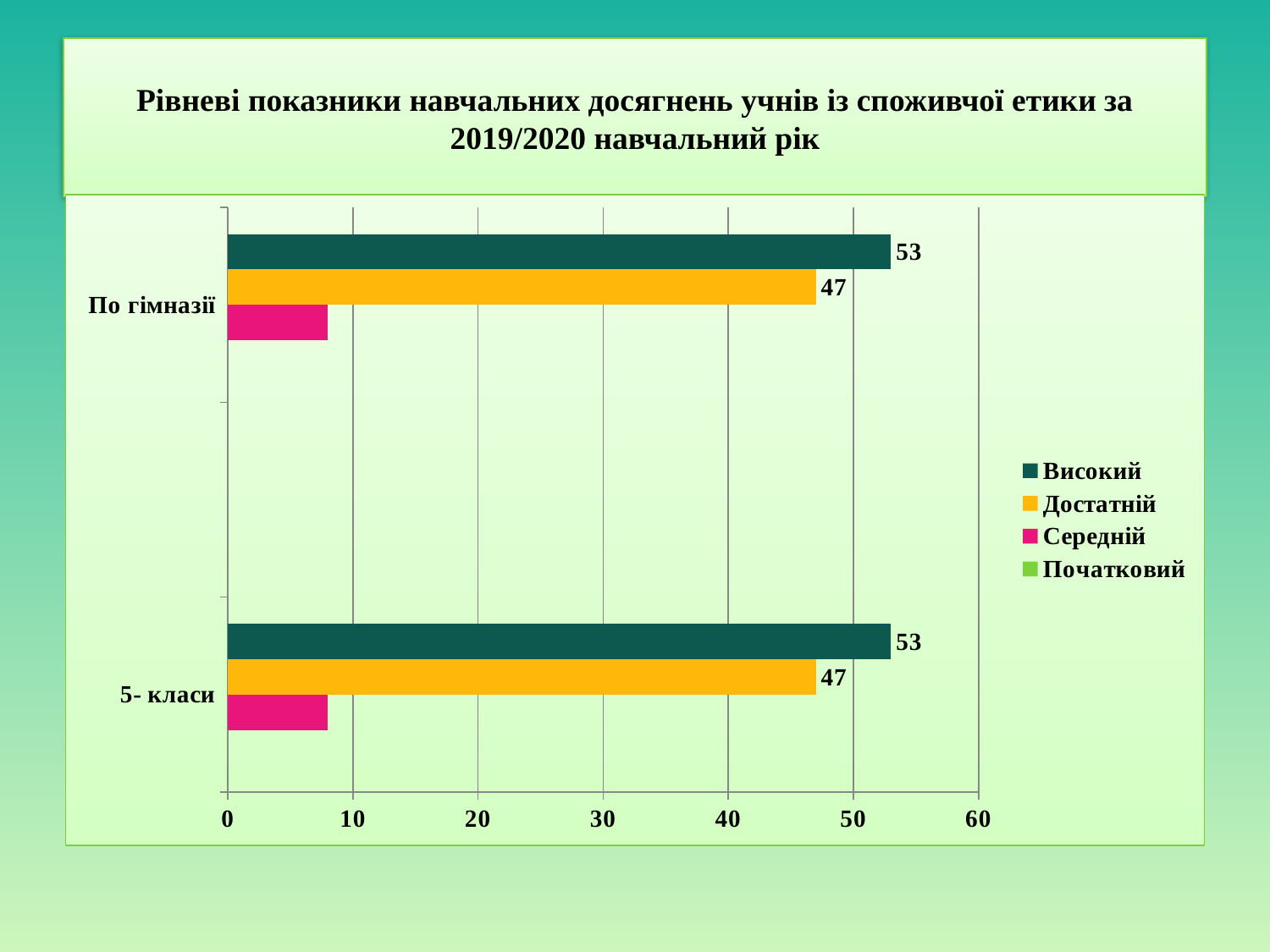
What is the value of Достатній for По гімназії? 47 What is the difference between Високий and Достатній for 5- класи? 6 Which series has the lowest plotted bar for 5- класи? Середній How many categories are shown on the vertical axis? 2 What is the value of Достатній for 5- класи? 47 What is the value of Високий for 5- класи? 53 Which series has the highest value for По гімназії? Високий How many series does the legend list? 4 What kind of chart is shown on the slide? bar chart For По гімназії, which is larger: Високий or Достатній? Високий What is the value of Високий for По гімназії? 53 Is the value of Середній for По гімназії greater or less than 10? less